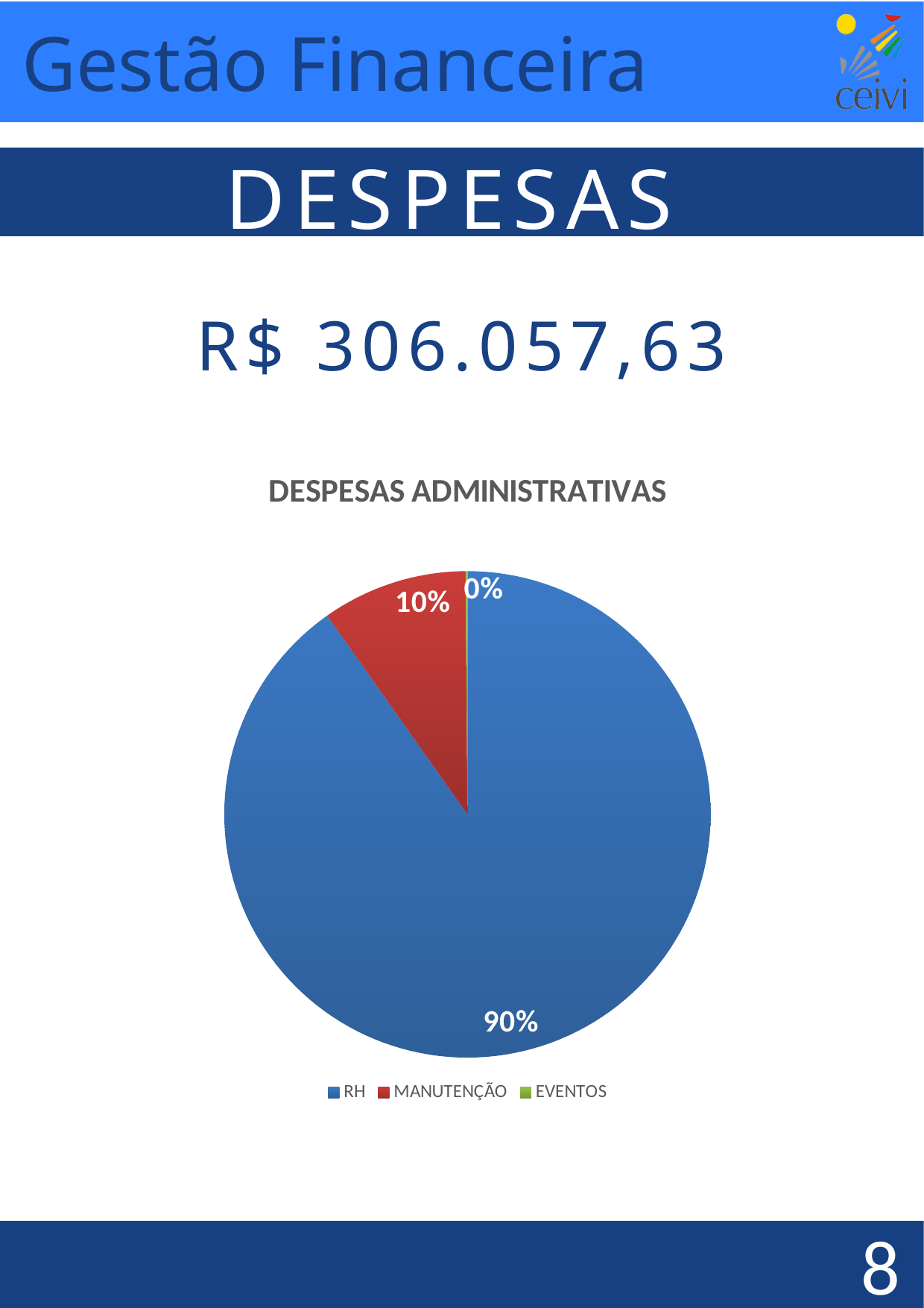
What share of the pie does EVENTOS represent? 0% Which category has the largest slice of the pie? RH Which category has the smallest slice of the pie? EVENTOS What colour is the MANUTENÇÃO slice? red How many categories does the legend list? 3 What is the difference in percentage points between the RH slice and the MANUTENÇÃO slice? 80% What kind of chart is shown on the slide? pie chart What share of the pie does RH represent? 90% What share of the pie does MANUTENÇÃO represent? 10% What is the title of the chart? DESPESAS ADMINISTRATIVAS Which is larger, the RH slice or the MANUTENÇÃO slice? RH